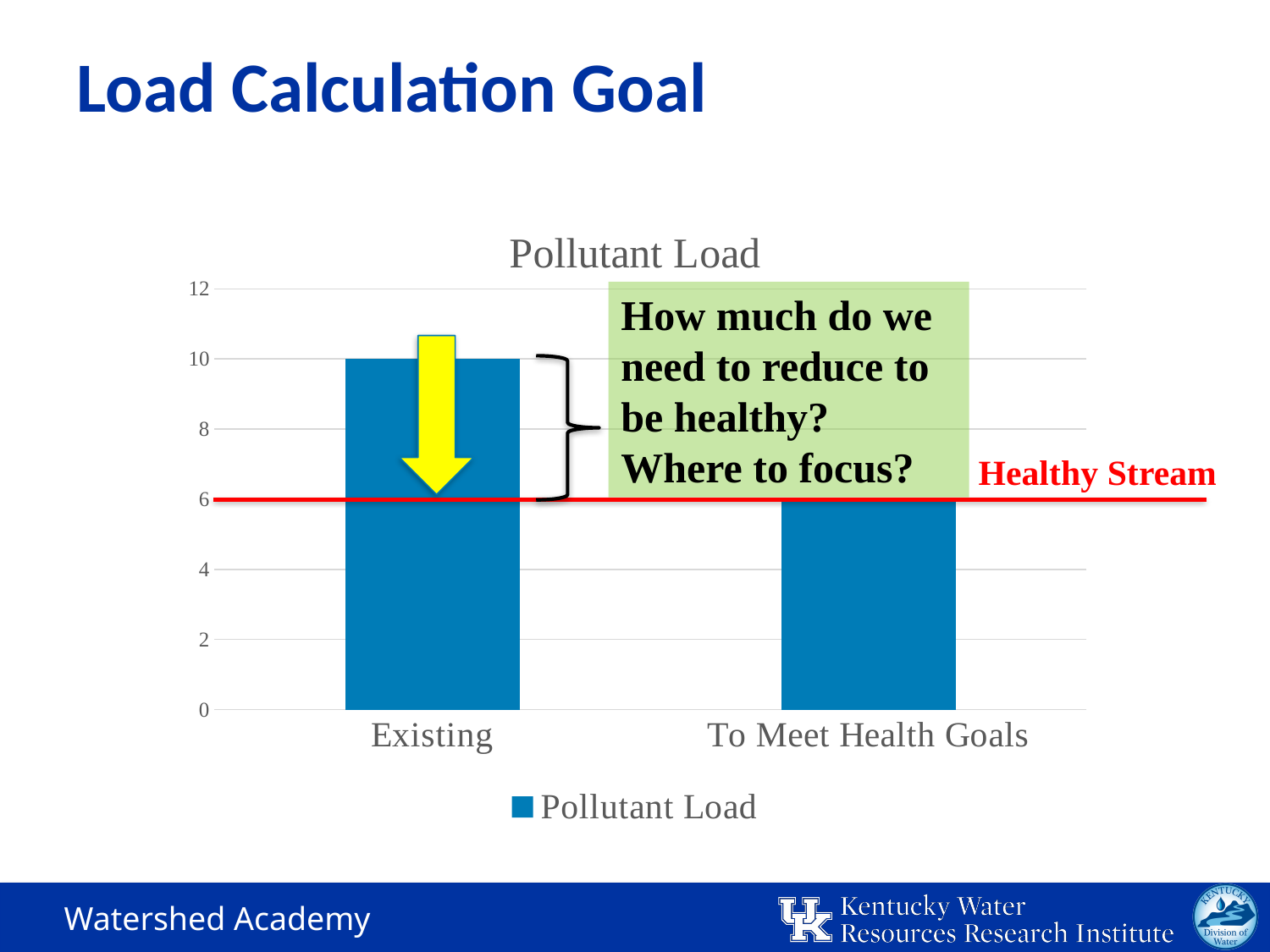
What label is written next to the red horizontal line on the chart? Healthy Stream What is the difference between the Pollutant Load for Existing and for To Meet Health Goals? 4 How many series does the chart legend list? 1 What is the title of the chart? Pollutant Load Which is larger, the Pollutant Load for Existing or for To Meet Health Goals? Existing What type of chart is shown on the slide? bar chart What is the Pollutant Load value for To Meet Health Goals? 6 Is the Pollutant Load for Existing greater or less than 8? greater Which category has the lowest Pollutant Load? To Meet Health Goals How many categories are shown on the x axis of the chart? 2 What is the Pollutant Load value for Existing? 10 Which category has the highest Pollutant Load? Existing